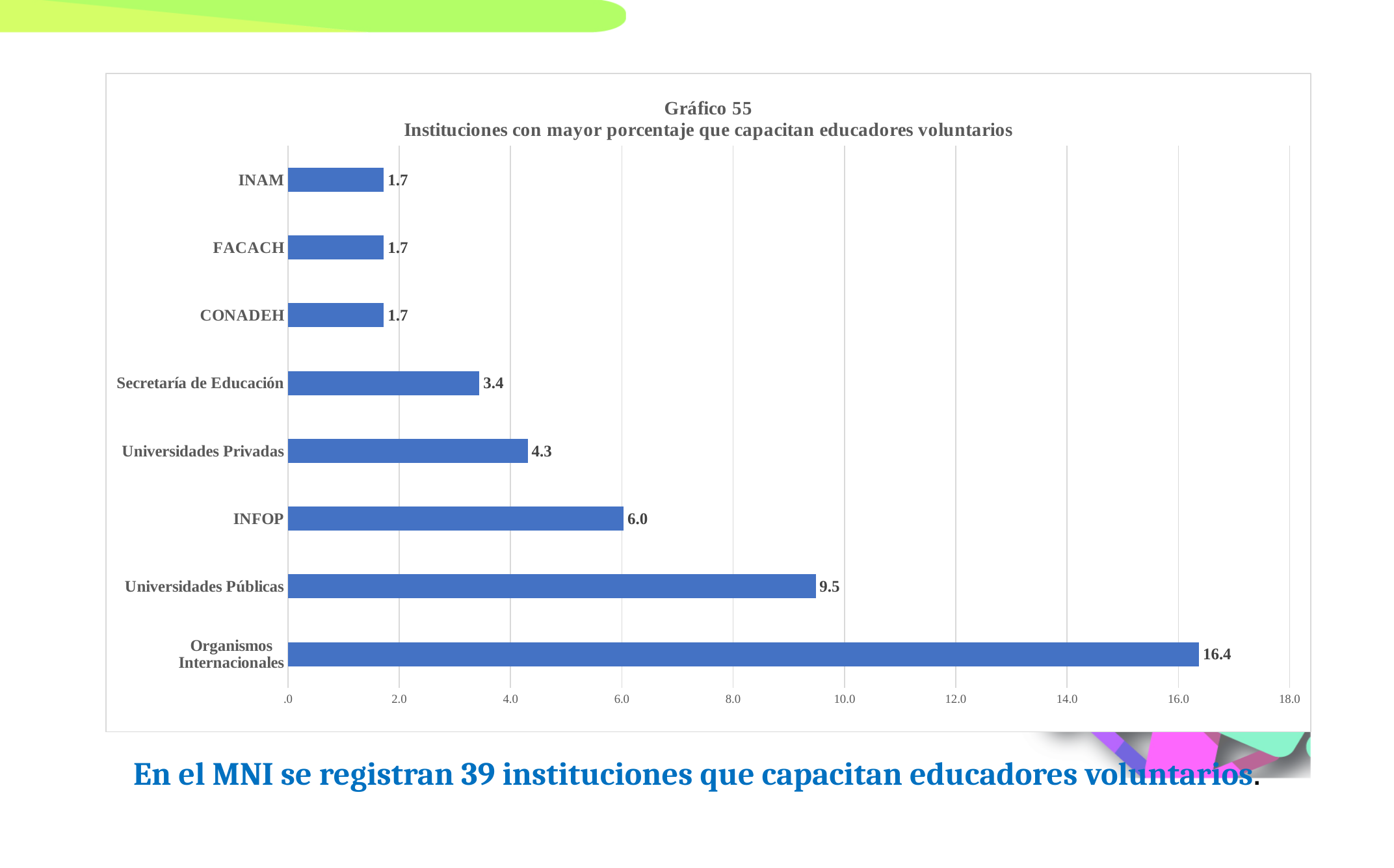
What is the value for Universidades Públicas? 9.5 How many categories are shown in the chart? 8 What is the title of the chart? Gráfico 55 Instituciones con mayor porcentaje que capacitan educadores voluntarios What is the difference between the values for Organismos Internacionales and Universidades Públicas? 6.9 What is the difference between the values for Universidades Privadas and Secretaría de Educación? 0.9 Is the value for Universidades Públicas greater or less than 8.0? greater Which is larger, the value for INFOP or the value for Universidades Privadas? INFOP What is the value for Organismos Internacionales? 16.4 Which category has the highest value? Organismos Internacionales What is the value for Secretaría de Educación? 3.4 What kind of chart is shown on the slide? Bar chart What is the value for INFOP? 6.0